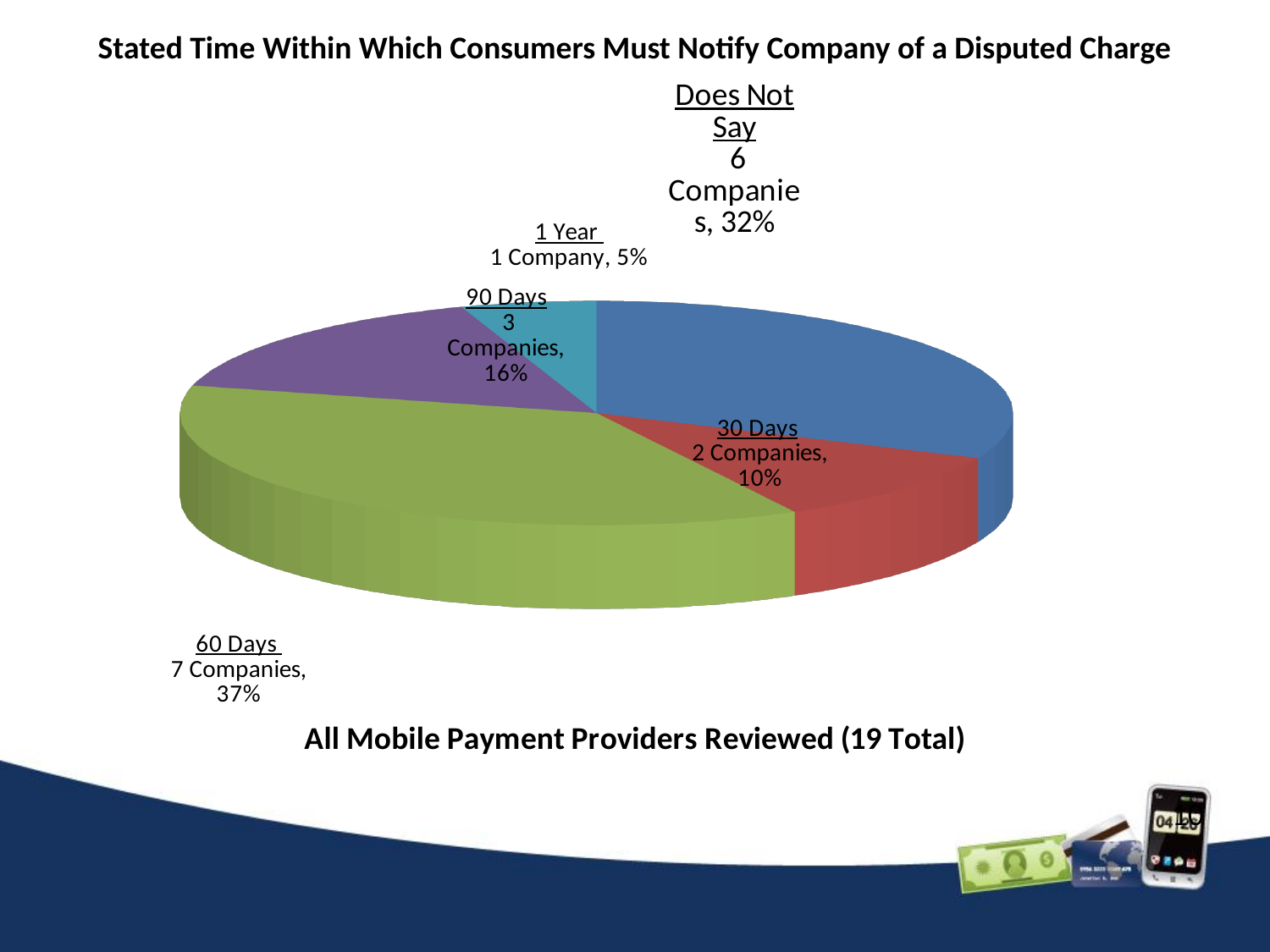
Which category has the smallest share of the pie? 1 Year What is the total number of mobile payment providers reviewed, according to the slide? 19 How many companies fall into the "Does Not Say" category? 6 Companies Which category has the largest share of the pie? 60 Days What percentage of companies state a 60 Days notification period? 37% What is the title of the chart? Stated Time Within Which Consumers Must Notify Company of a Disputed Charge How many categories does the pie chart show? 5 What kind of chart is shown on the slide? Pie chart What percentage of companies state a 90 Days notification period? 16% Which has more companies: 30 Days or Does Not Say? Does Not Say How many more companies are in the 60 Days category than in the 90 Days category? 4 How many companies state a 30 Days notification period? 2 Companies